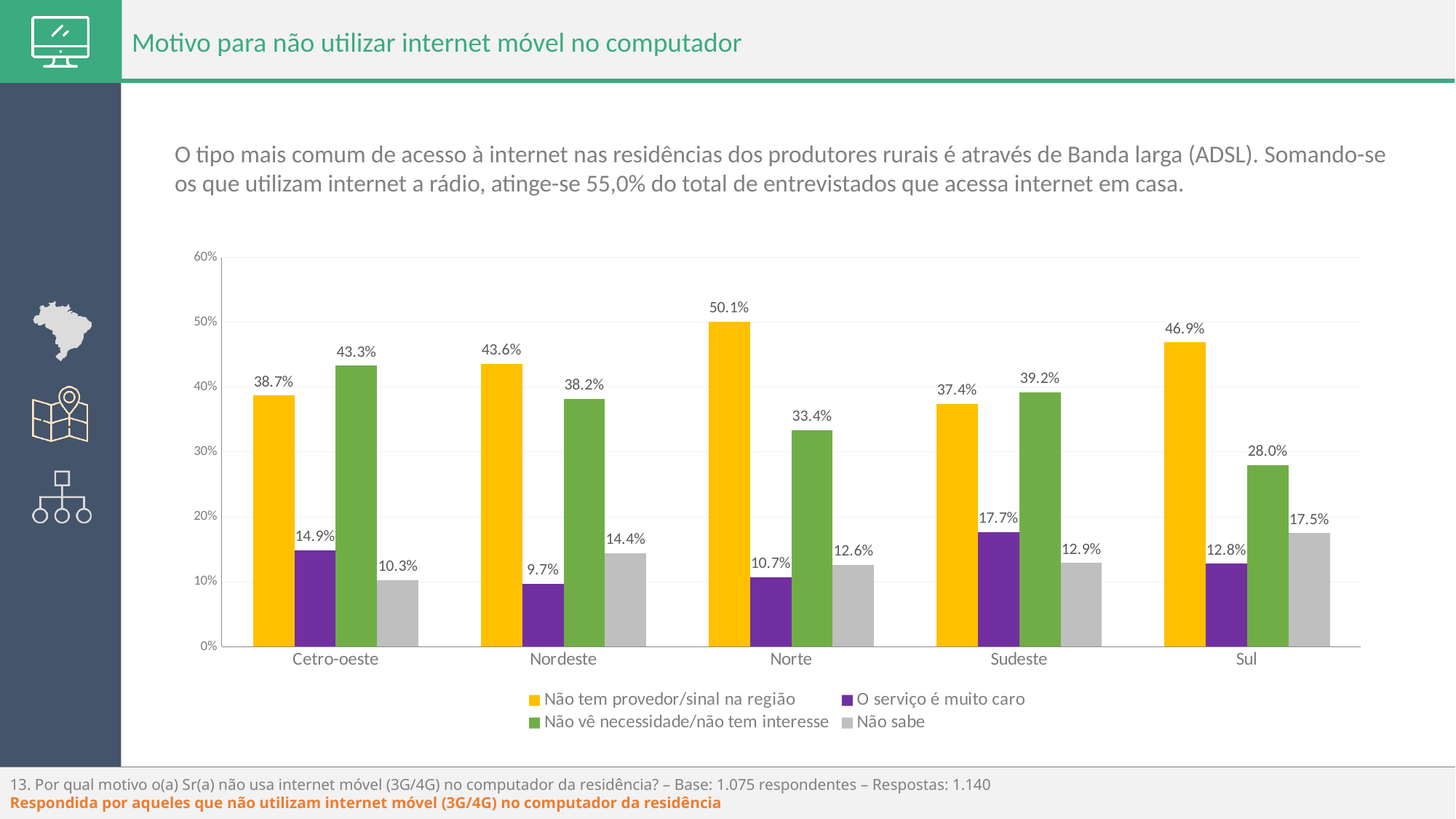
Which region has the lowest value for "O serviço é muito caro"? Nordeste Which region has the highest value for "Não tem provedor/sinal na região"? Norte Which colour represents "Não sabe" in the chart? grey Is the value for "Não sabe" in Sul greater or less than 20%? less How many regions are shown on the x axis? 5 What is the value for "Não sabe" in Nordeste? 14.4% What is the value for "Não tem provedor/sinal na região" in Norte? 50.1% How many series does the legend list? 4 What is the value for "O serviço é muito caro" in Sudeste? 17.7% What kind of chart is shown on the slide? bar chart Which is larger in Cetro-oeste: "Não tem provedor/sinal na região" or "Não vê necessidade/não tem interesse"? Não vê necessidade/não tem interesse What is the difference between "Não vê necessidade/não tem interesse" in Cetro-oeste and in Sul? 15.3%